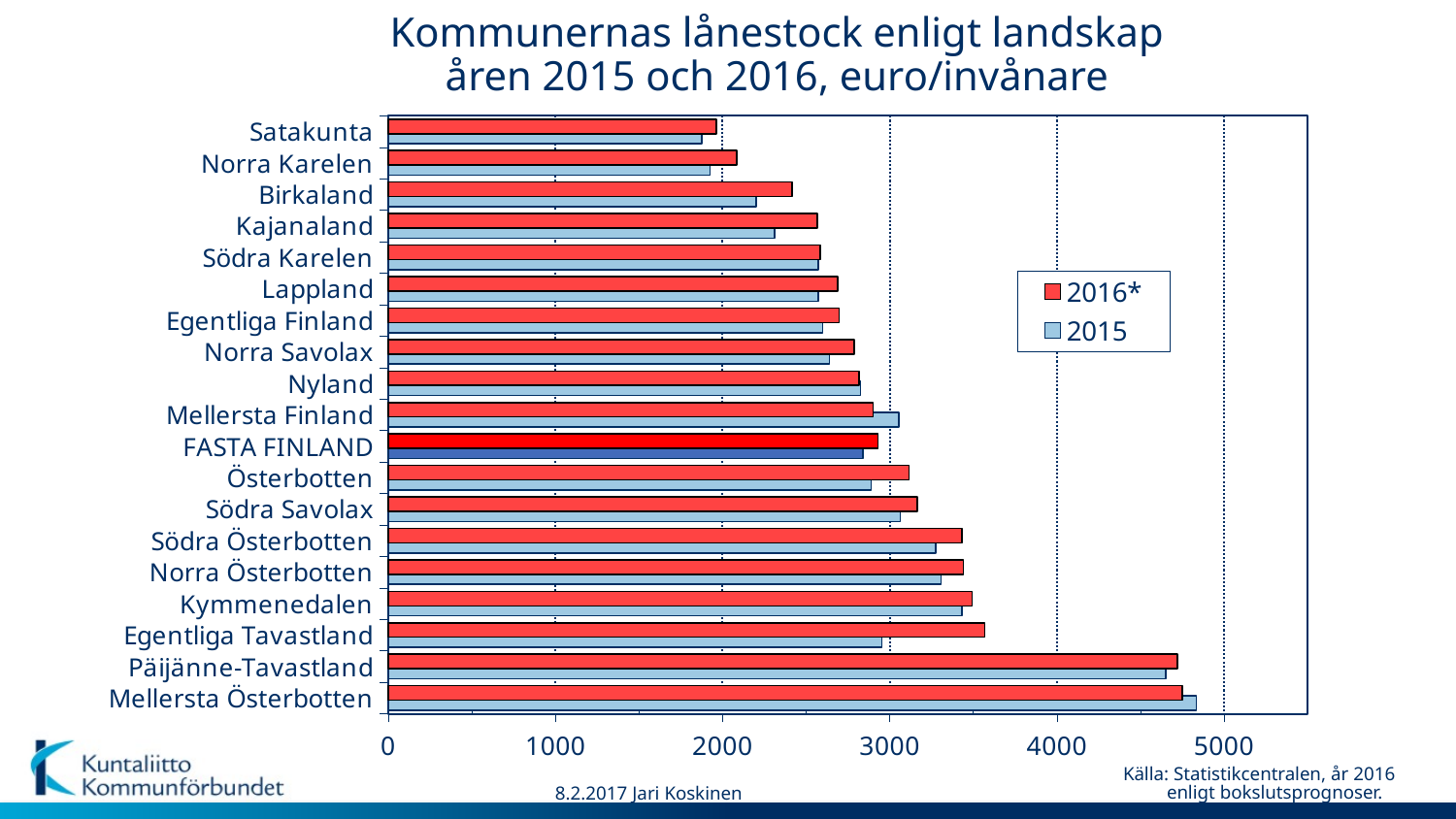
Is the 2016* value for Kymmenedalen greater or less than 3000? greater For Mellersta Finland, which is larger: the 2016* value or the 2015 value? 2015 Is the 2015 value for Mellersta Österbotten greater or less than 4000? greater Which region has the lowest value for 2016*? Satakunta What are the two series names shown in the legend? 2016* and 2015 How many series does the legend list? 2 For Egentliga Tavastland, which is larger: the 2016* value or the 2015 value? 2016* Is the 2016* value for Satakunta greater or less than 2000? less Which region has the highest value for 2015? Mellersta Österbotten How many regions (categories) are plotted on the chart? 19 What kind of chart is shown on the slide? bar chart